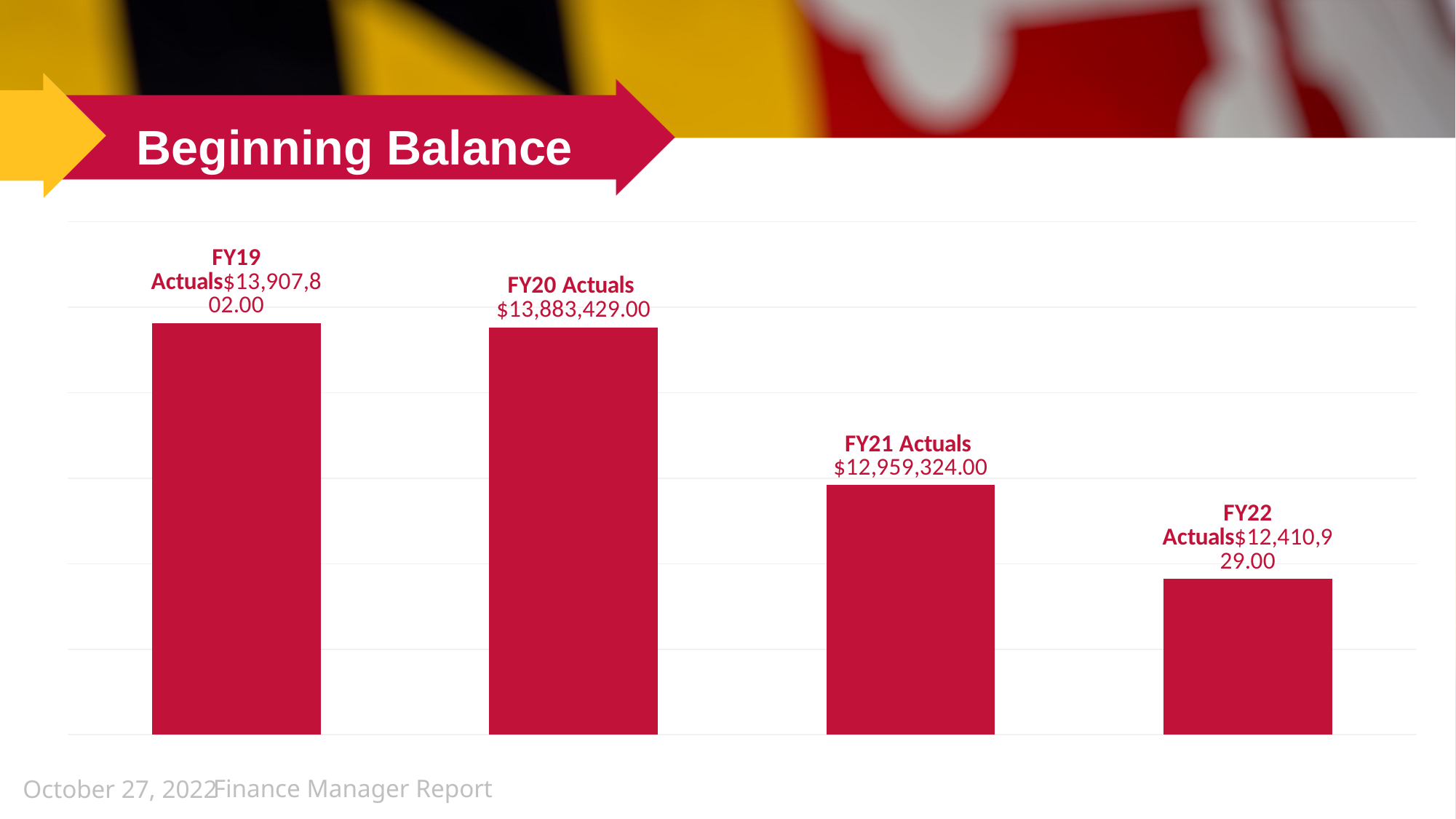
What is the difference between the FY20 Actuals and FY21 Actuals values? $924,105.00 What is the value for FY19 Actuals? $13,907,802.00 What kind of chart is shown on the slide? Bar chart What is the value for FY22 Actuals? $12,410,929.00 Which is larger, the value for FY19 Actuals or FY20 Actuals? FY19 Actuals What is the value for FY20 Actuals? $13,883,429.00 What is the difference between the FY21 Actuals and FY22 Actuals values? $548,395.00 Do the values rise or fall from FY19 to FY22? Fall How many bars are shown in the chart? 4 Which fiscal year has the lowest beginning balance? FY22 Actuals What is the value for FY21 Actuals? $12,959,324.00 Which fiscal year has the highest beginning balance? FY19 Actuals